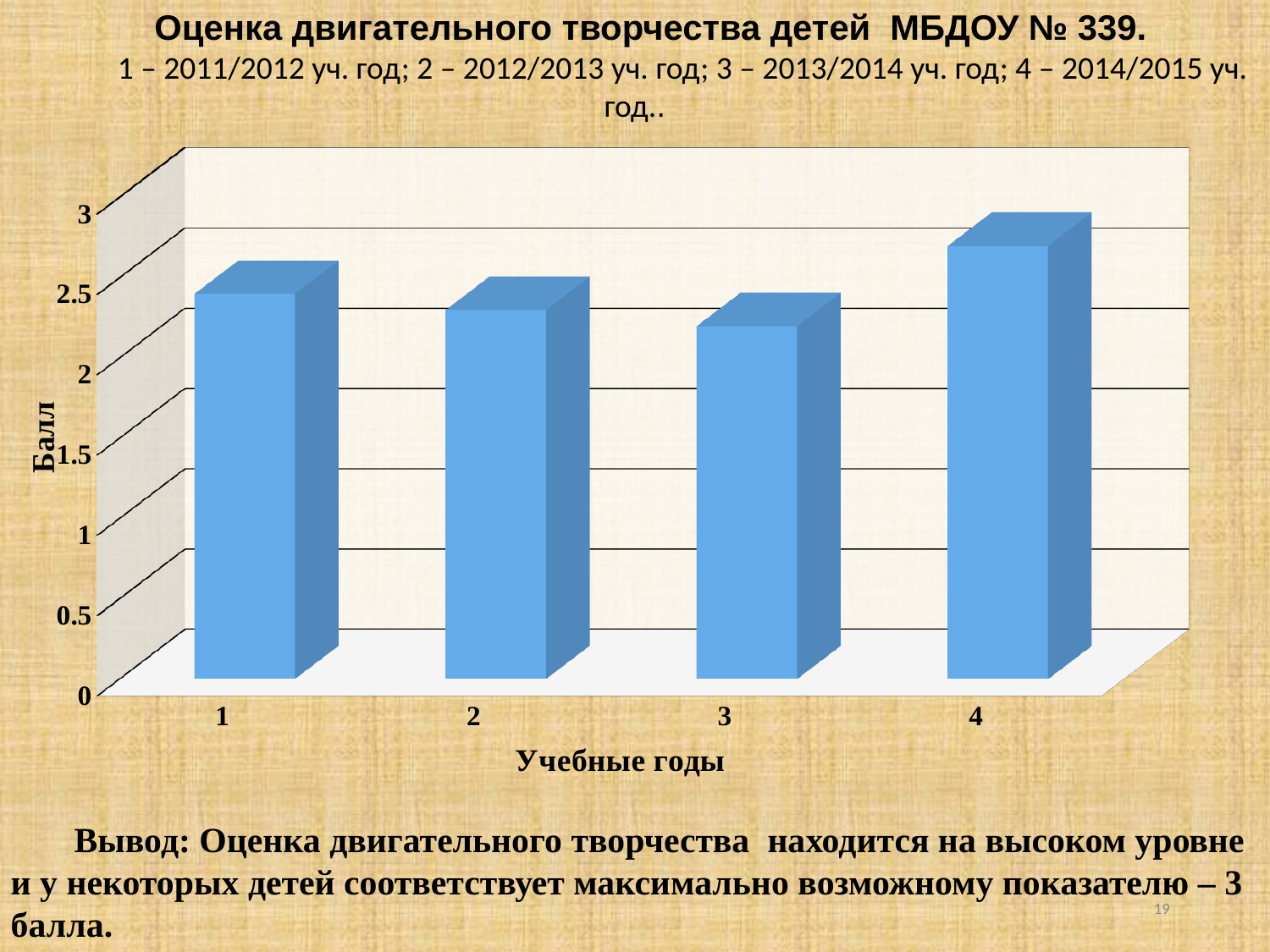
Is the value for category 3 greater or less than 2.5? less Which category has the highest bar? 4 Is the value for category 4 greater or less than 2.5? greater What kind of chart is shown on the slide? bar chart What is the title of the vertical axis? Балл Is the value for category 2 greater or less than 2.5? less How many bars (categories) are plotted on the chart? 4 Which category has the lowest bar? 3 Which is larger, the value for category 4 or the value for category 3? 4 Do the values rise or fall from category 3 to category 4? rise What is the title of the horizontal axis? Учебные годы